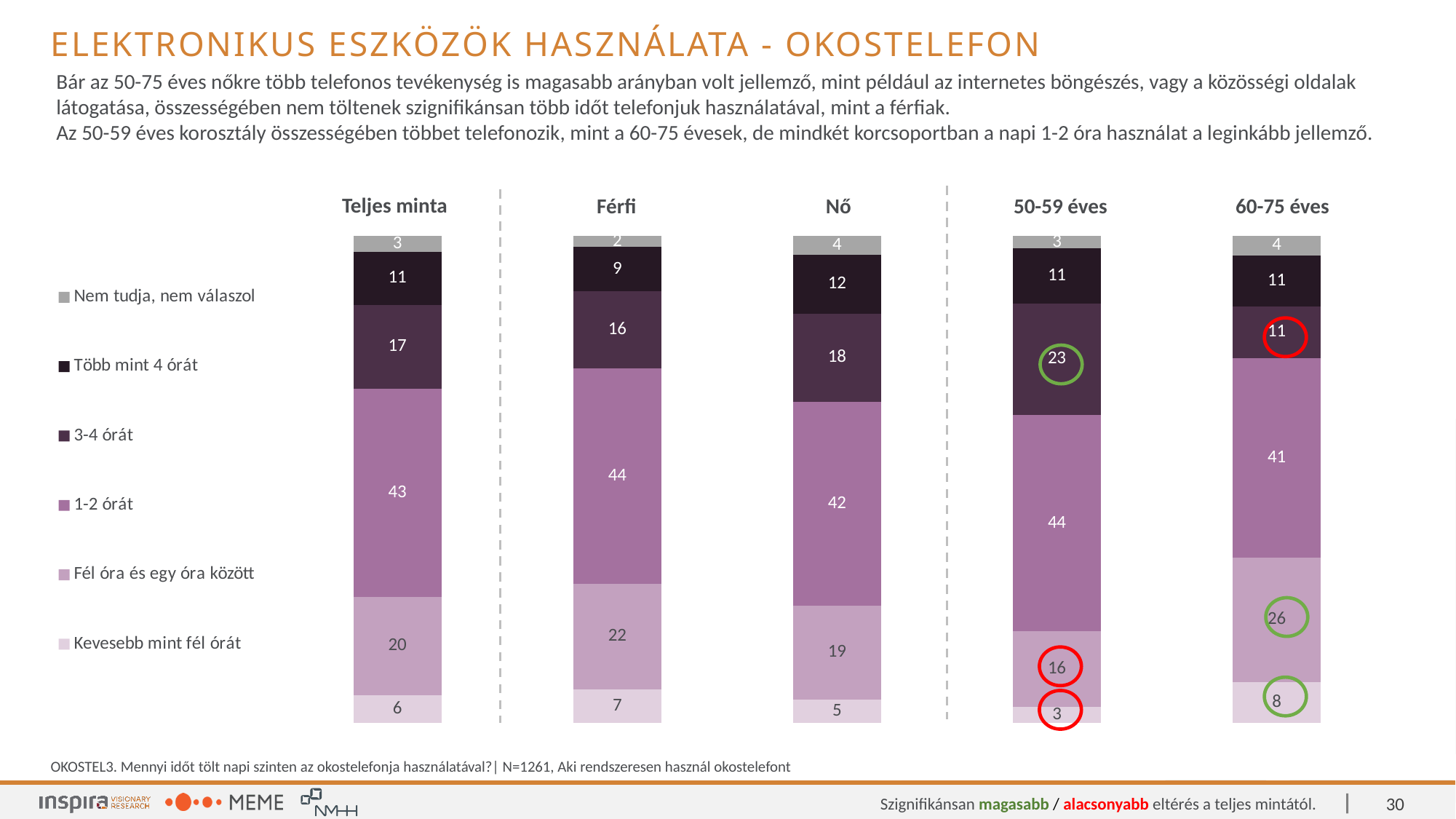
How many series does the legend list? 6 What kind of chart is shown on the slide? Stacked bar chart What is the value for "1-2 órát" in the Teljes minta bar? 43 What is the difference between the "3-4 órát" values for 50-59 éves and 60-75 éves? 12 What is the value for "Fél óra és egy óra között" in the 60-75 éves bar? 26 How many bars (groups) are shown in the chart? 5 Which group has the lowest value for "Kevesebb mint fél órát"? 50-59 éves What is the total of the Férfi stacked bar? 100 What is the value for "Kevesebb mint fél órát" in the Férfi bar? 7 What is the value for "3-4 órát" in the 50-59 éves bar? 23 Which is larger: the "Több mint 4 órát" value for Férfi or for Nő? Nő Which group has the highest value for "Fél óra és egy óra között"? 60-75 éves